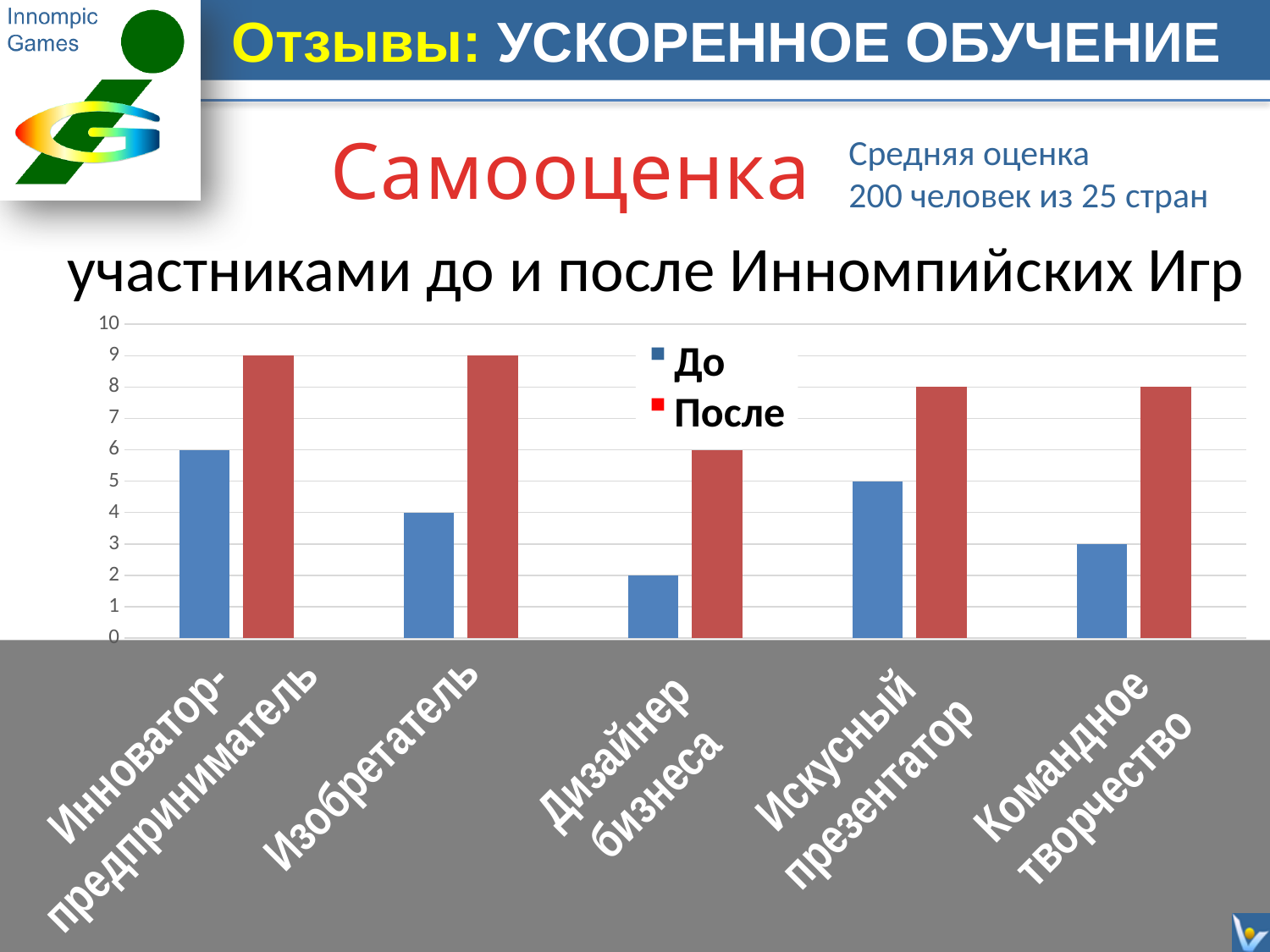
What is the value of "До" for "Командное творчество"? 3 What is the difference between the "После" and "До" values for "Изобретатель"? 5 What kind of chart is shown on the slide? bar chart Which category has the highest "До" value? Инноватор-предприниматель Which category has the lowest "До" value? Дизайнер бизнеса Which is larger: the "До" value for "Искусный презентатор" or the "До" value for "Командное творчество"? Искусный презентатор What is the value of "После" for "Искусный презентатор"? 8 How many series does the legend list? 2 What is the value of "После" for "Дизайнер бизнеса"? 6 How many categories are shown on the x axis? 5 Which series is shown in red in the legend? После What is the value of "До" for "Изобретатель"? 4